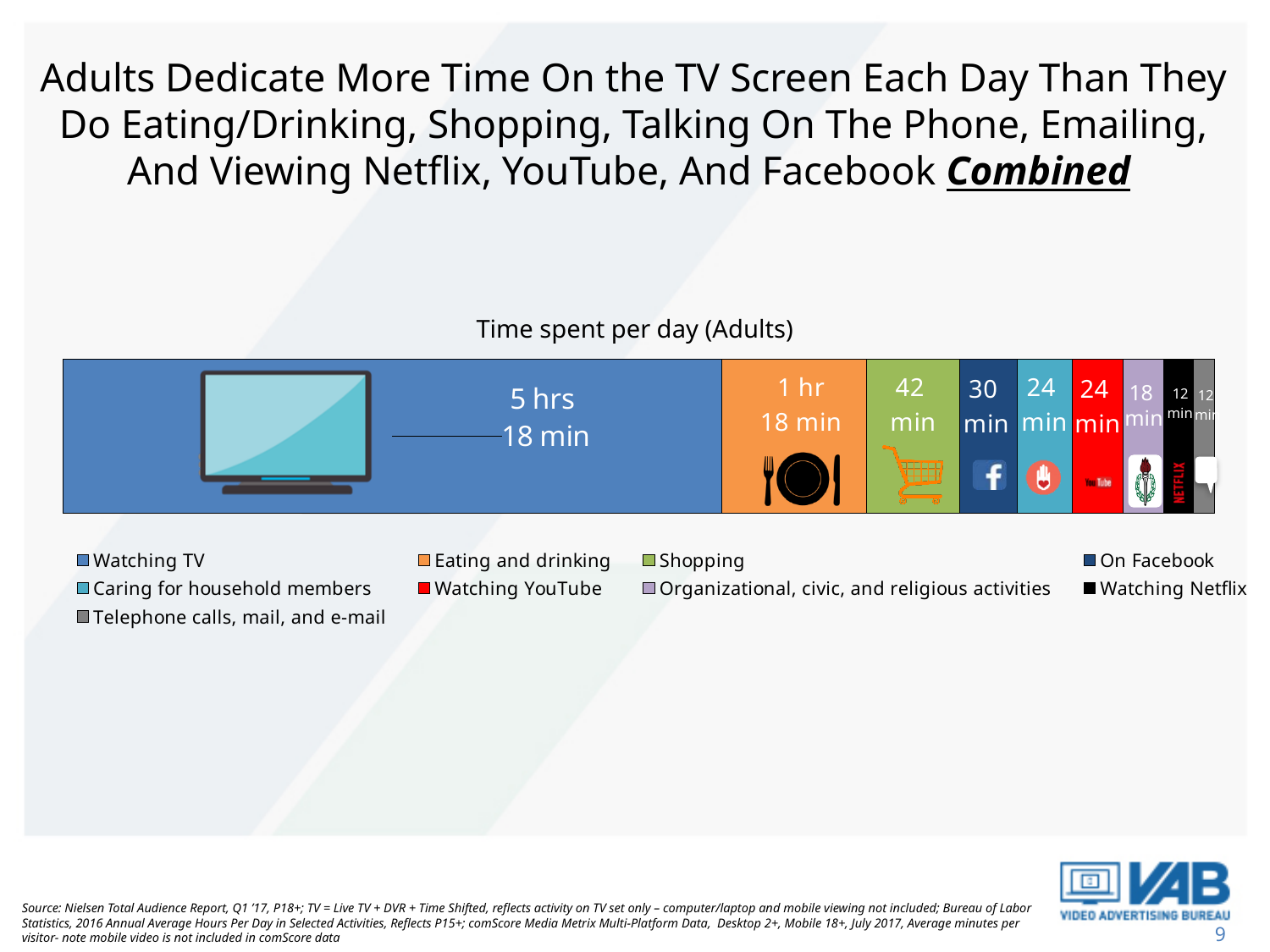
What is the value shown for shopping? 42 min What is the difference between the time spent shopping and the time spent on Facebook? 12 min Which colour represents Watching Netflix in the legend? Black How much time per day do adults spend watching TV according to the chart? 5 hrs 18 min What kind of chart is shown on the slide? Stacked bar chart Which is larger, the time spent shopping or the time spent on Facebook? Shopping How many series does the legend list? 9 What is the value shown for eating and drinking? 1 hr 18 min What is the value shown for watching YouTube? 24 min What is the chart's title? Time spent per day (Adults) What is the value shown for time on Facebook? 30 min Which activity has the largest segment in the bar? Watching TV